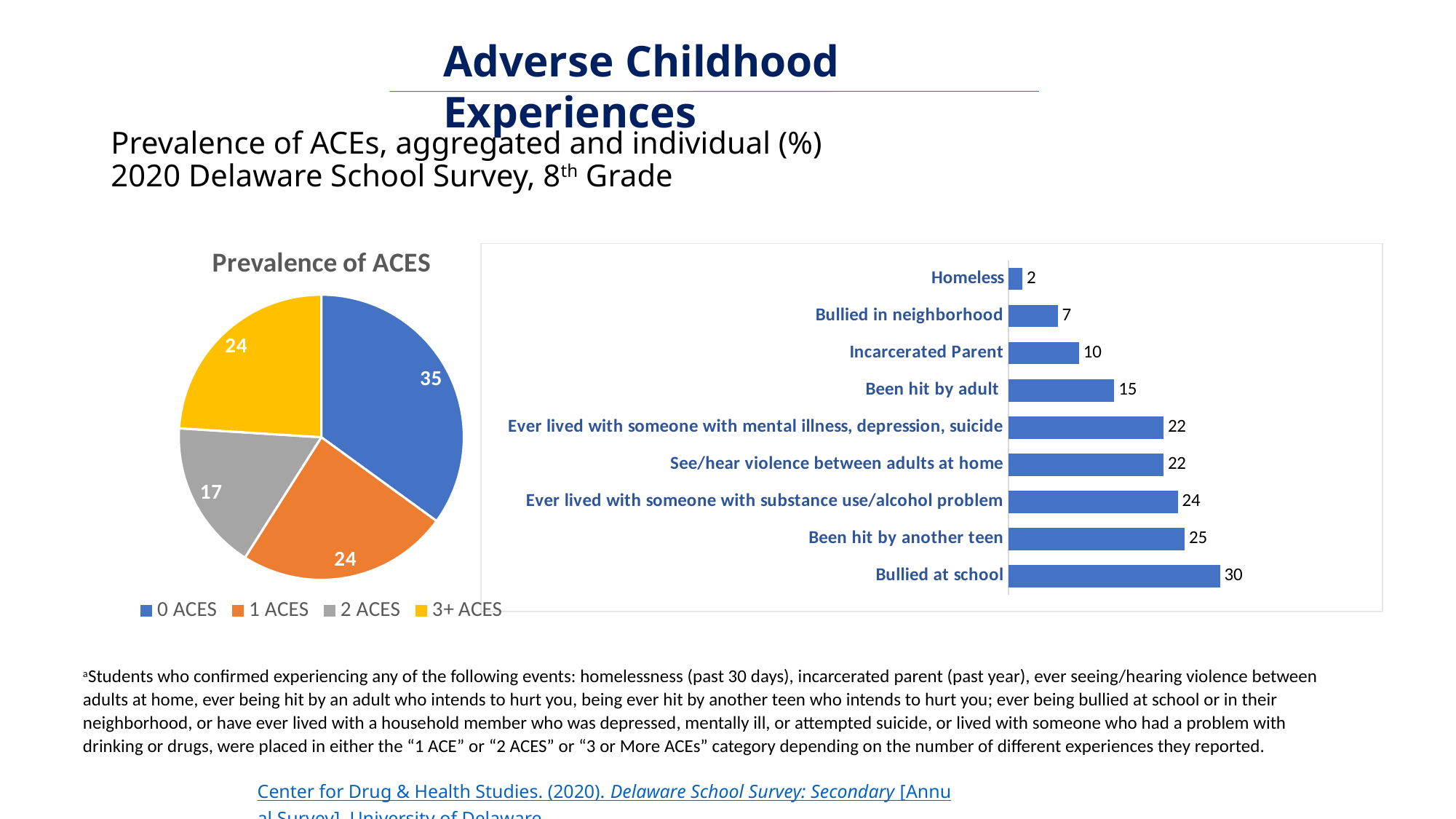
In the bar chart on the right, which category has the lowest value? Homeless In the 'Prevalence of ACES' pie chart, what is the value for 0 ACES? 35 In the 'Prevalence of ACES' pie chart, which category has the smallest slice? 2 ACES In the 'Prevalence of ACES' pie chart, what colour is the 3+ ACES slice? Yellow In the 'Prevalence of ACES' pie chart, what is the value for 2 ACES? 17 In the bar chart on the right, what is the value for 'Incarcerated Parent'? 10 In the 'Prevalence of ACES' pie chart, how many categories does the legend list? 4 In the 'Prevalence of ACES' pie chart, which category has the largest slice? 0 ACES In the bar chart on the right, how many categories are plotted? 9 In the bar chart on the right, which is larger: 'Been hit by another teen' or 'Been hit by adult'? Been hit by another teen In the bar chart on the right, what is the value for 'Bullied at school'? 30 In the bar chart on the right, what is the difference between 'Bullied at school' and 'Bullied in neighborhood'? 23